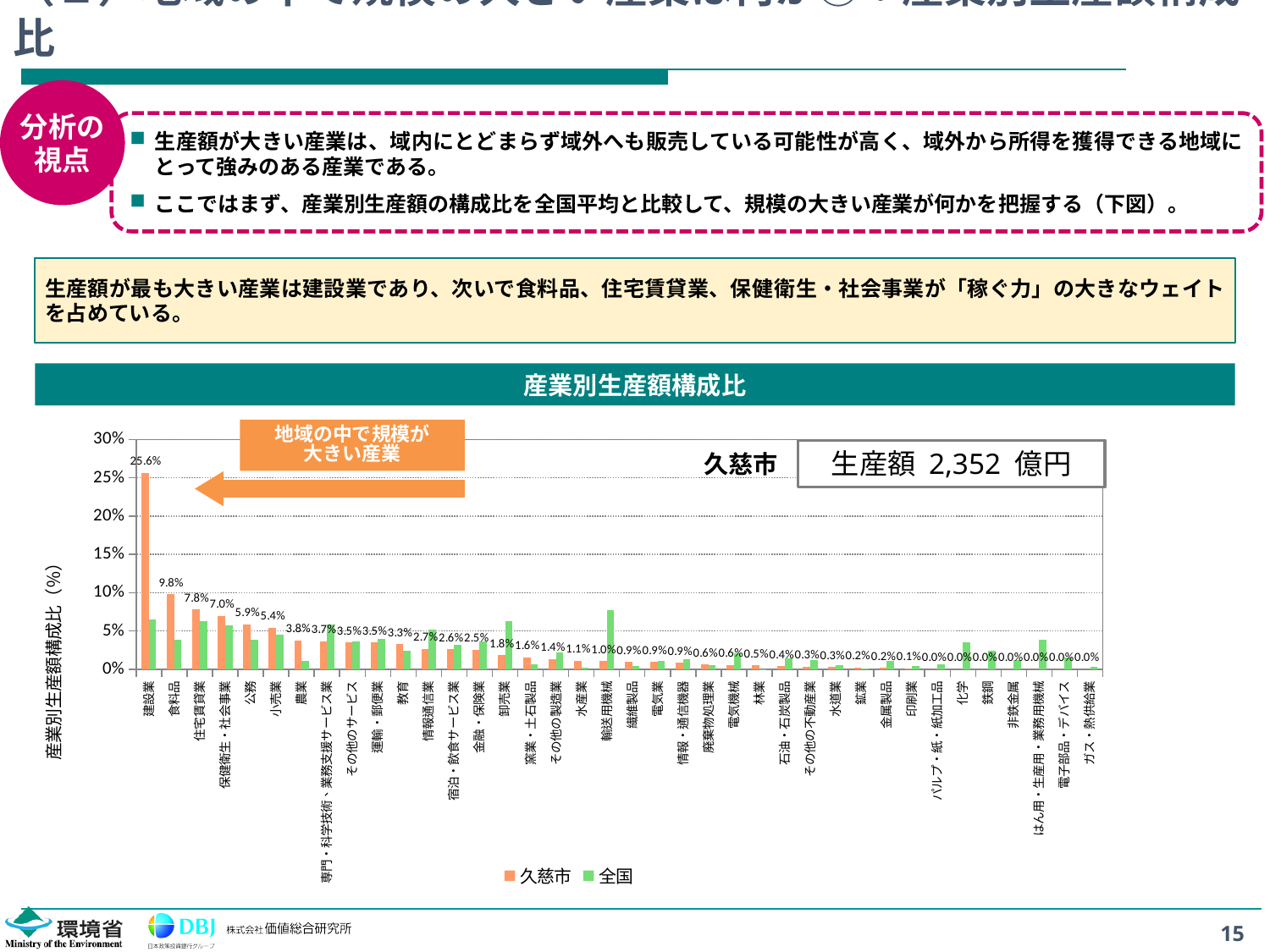
What type of chart is shown under the title 産業別生産額構成比? bar chart What is the 久慈市 value for 保健衛生・社会事業? 7.0% Which is larger for 久慈市: 住宅賃貸業 or 公務? 住宅賃貸業 Is the 全国 value for 輸送用機械 greater or less than 5%? greater How many series does the legend of the 産業別生産額構成比 chart list? 2 What is the 久慈市 value for 食料品? 9.8% Is the 全国 value for 食料品 greater or less than 5%? less What total production value (生産額) is shown in the box on the chart for 久慈市? 2,352 億円 Which series is shown in orange in the chart? 久慈市 Which category has the highest 久慈市 value in the chart? 建設業 What is the 久慈市 value for 建設業 in the 産業別生産額構成比 chart? 25.6% What is the difference between the 久慈市 values for 建設業 and 食料品? 15.8%